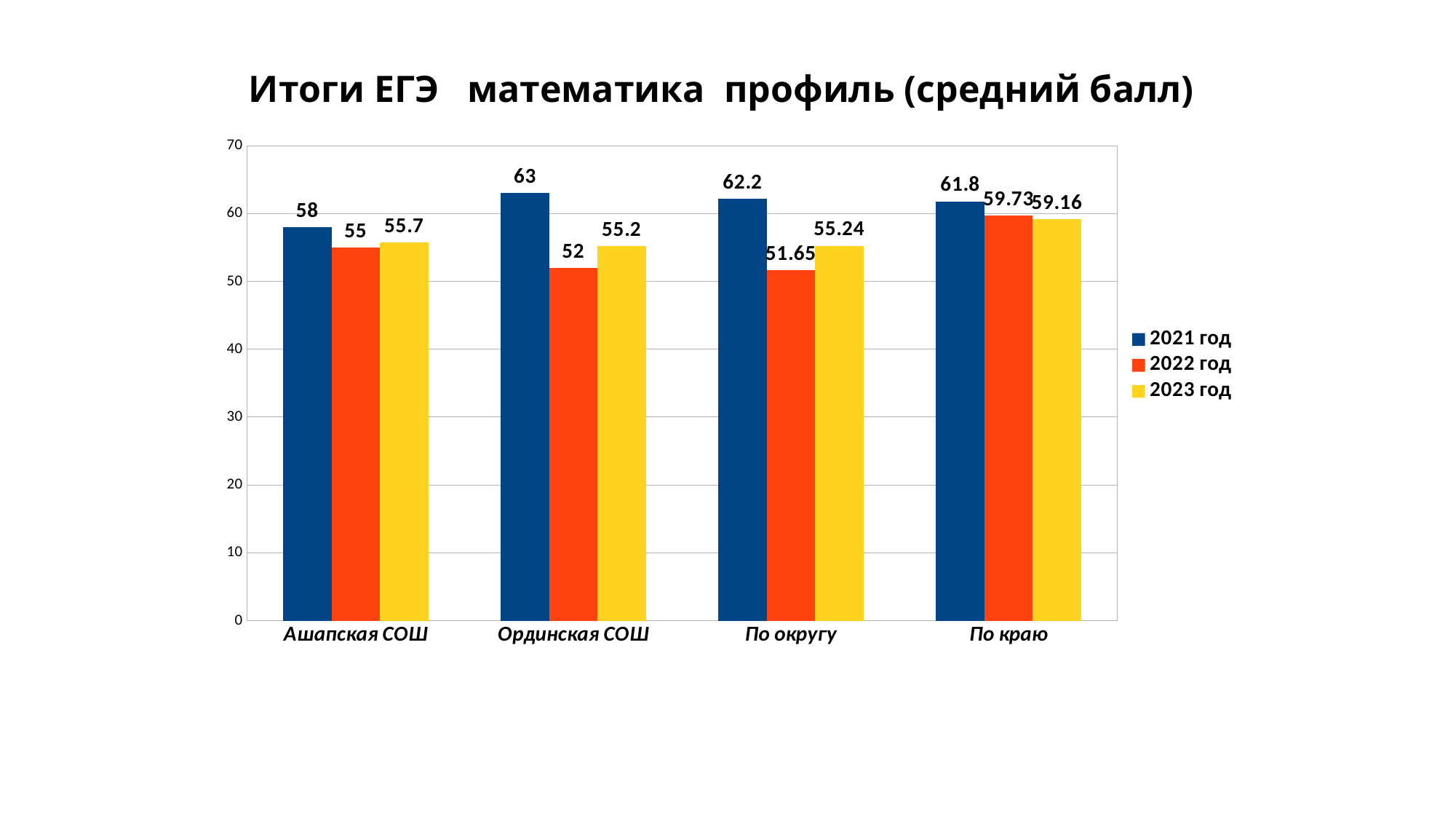
Is the value for По краю in the 2022 год series greater or less than 50? greater What is the value for По округу in the 2022 год series? 51.65 What is the title of the chart? Итоги ЕГЭ математика профиль (средний балл) How many categories are shown on the x axis? 4 Which category has the lowest value in the 2022 год series? По округу Which category has the highest value in the 2021 год series? Ординская СОШ What kind of chart is shown on the slide? bar chart What is the value for По краю in the 2023 год series? 59.16 How many series does the legend list? 3 What is the difference between the 2021 год and 2022 год values for Ординская СОШ? 11 What is the value for Ашапская СОШ in the 2021 год series? 58 Which is larger for Ашапская СОШ: the 2022 год value or the 2023 год value? 2023 год